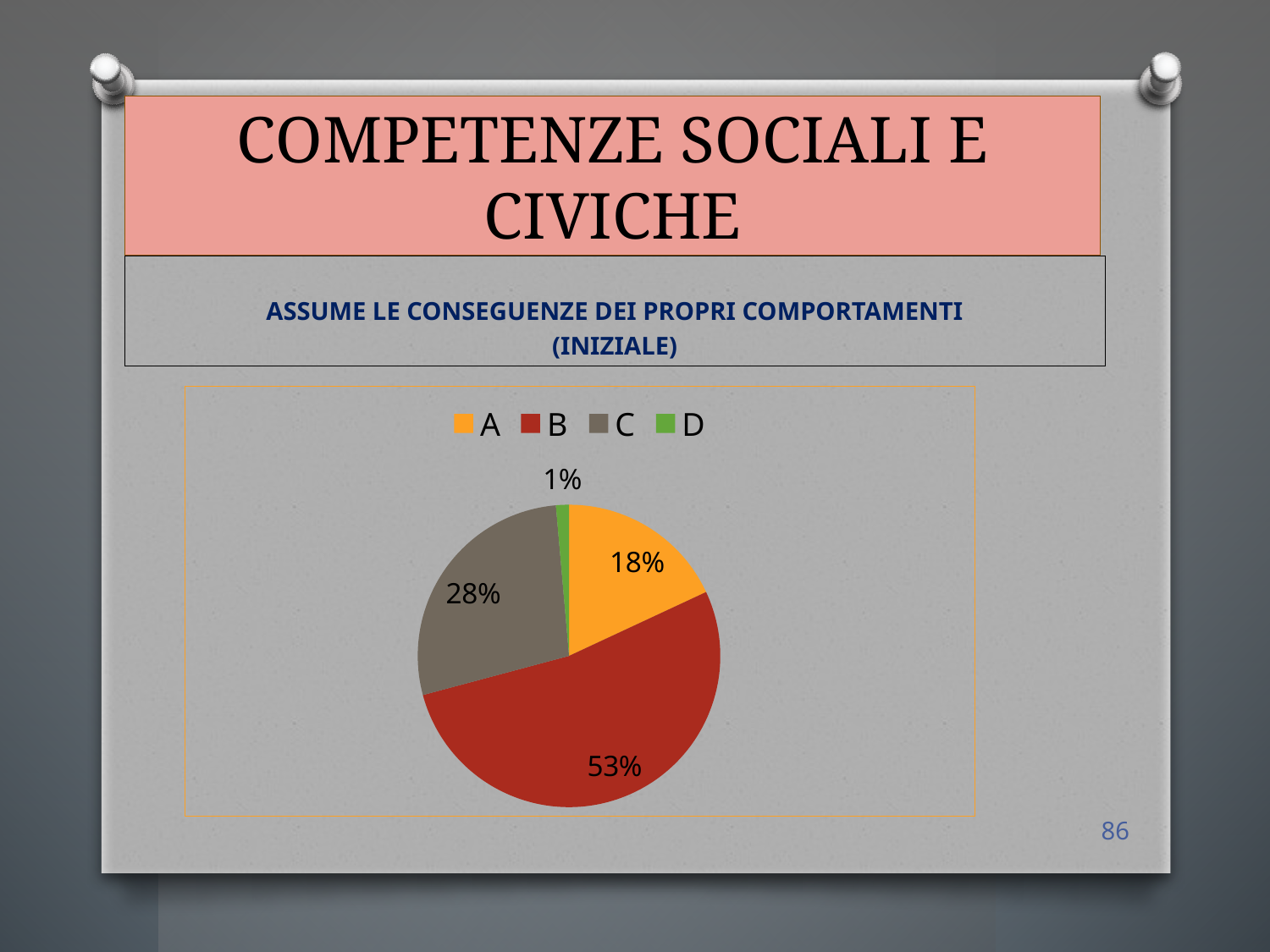
What percentage does slice C represent in the pie chart? 28% What percentage does slice B represent in the pie chart? 53% What percentage does slice D represent in the pie chart? 1% How many categories does the legend of the pie chart list? 4 What kind of chart is shown on the slide? pie chart Which is larger, slice A or slice C? C What percentage does slice A represent in the pie chart? 18% What colour is slice B in the pie chart? red Which category has the largest slice of the pie chart? B What is the difference in percentage points between slice B and slice C? 25 What is the difference in percentage points between slice A and slice D? 17 Which category has the smallest slice of the pie chart? D